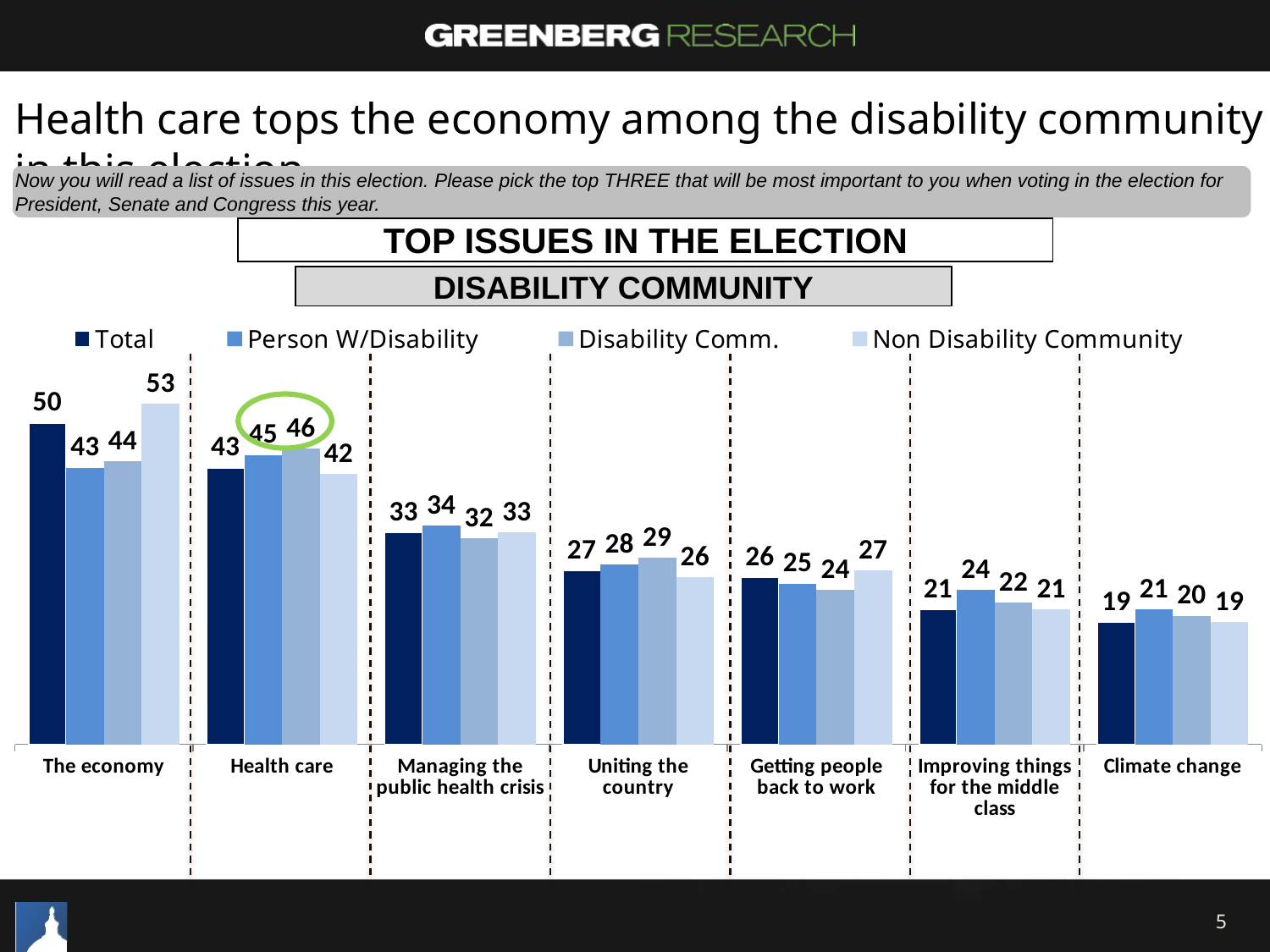
What is the difference between the Non Disability Community value and the Total value for The economy? 3 Which category has the lowest value for Total? Climate change What is the value for Person W/Disability for Improving things for the middle class? 24 For Health care, which is larger: the Disability Comm. value or the Non Disability Community value? Disability Comm. What kind of chart is shown on the slide? Bar chart Which category has the highest value for Non Disability Community? The economy What is the value for Non Disability Community for The economy? 53 Which category's bars are circled in green on the chart? Health care What is the value for Disability Comm. for Health care? 46 How many categories are shown on the x axis? 7 How many series does the legend list? 4 What is the value for Total for The economy? 50